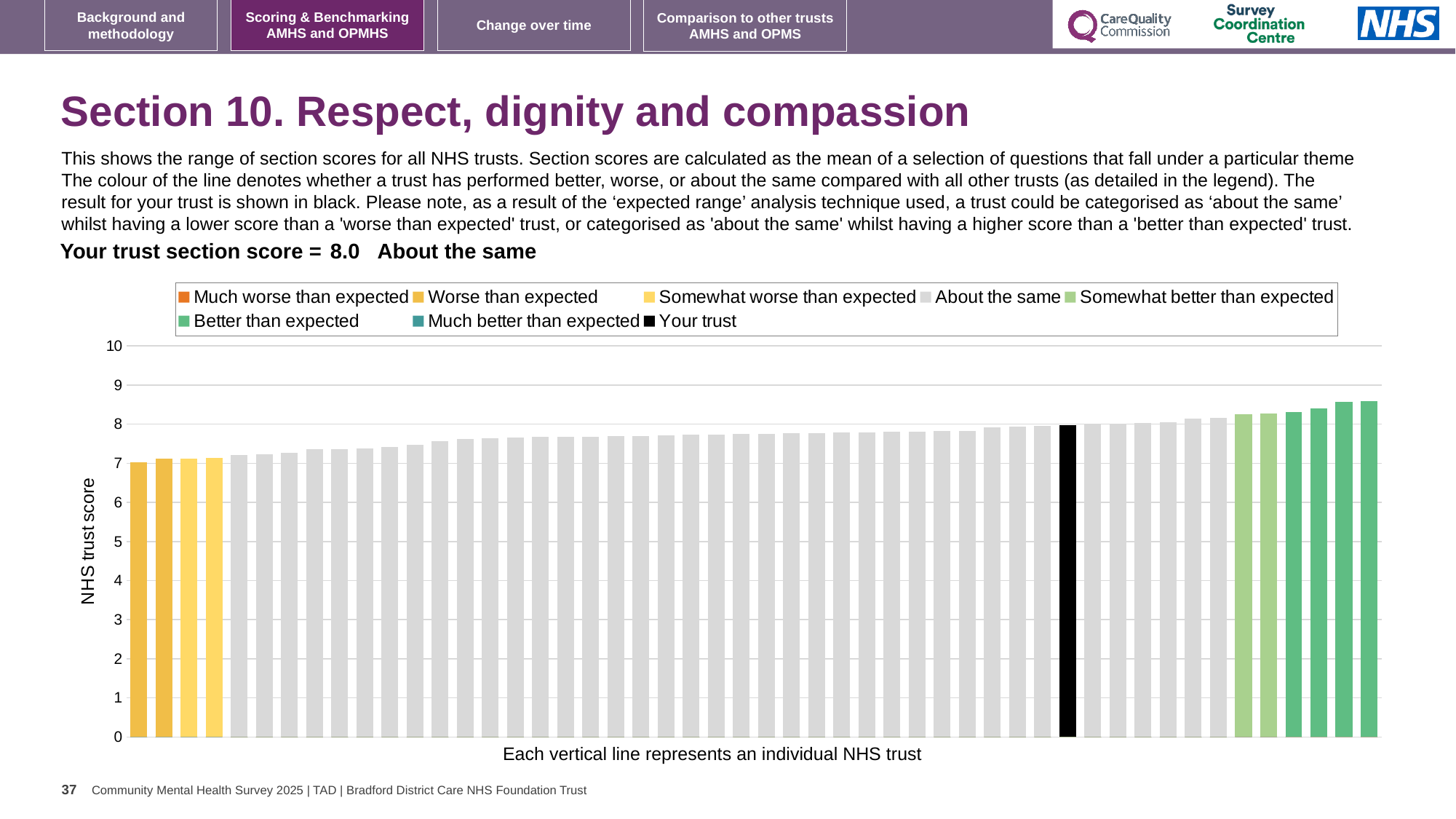
What is the label on the vertical axis of the chart? NHS trust score Is the value of the tallest bar on the right of the chart greater or less than 8? greater Which is taller: the black 'Your trust' bar or the leftmost bar? the black 'Your trust' bar How many bars on the chart are coloured green (somewhat better or better than expected)? 6 What category is your trust placed in for this section, as stated on the slide? About the same How many entries does the chart legend list? 8 What type of chart is shown on the slide? bar chart Is the value of the black 'Your trust' bar greater or less than 7? greater Do the bar values rise or fall from left to right across the chart? rise Is the value of the leftmost bar greater or less than 8? less What is your trust's section score for Section 10, Respect, dignity and compassion? 8.0